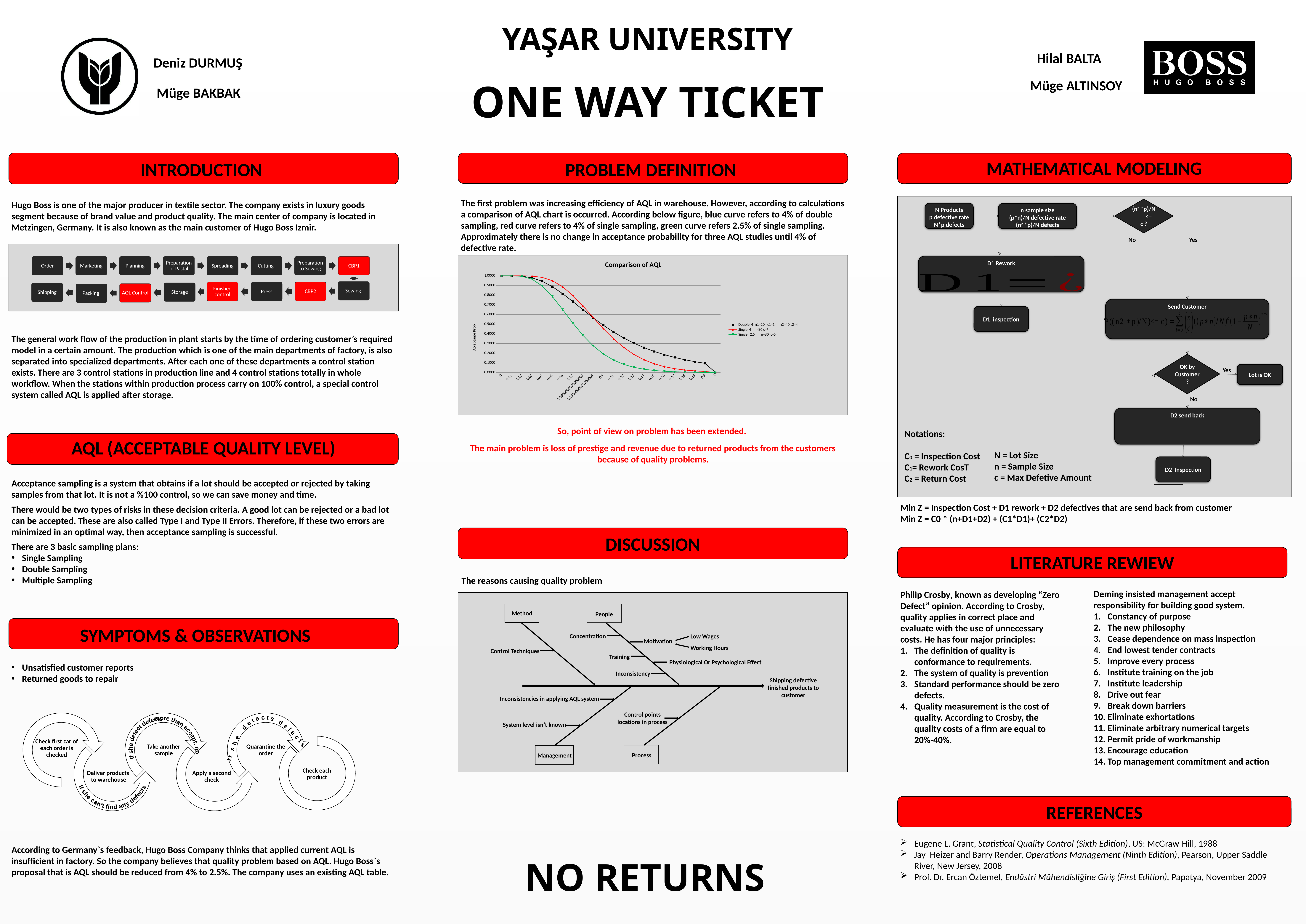
In the "Comparison of AQL" chart, which series has the lowest acceptance probability at a defective rate of 0.1? Single 2.5 In the "Comparison of AQL" chart, is the value of the green "Single 2.5" curve at a defective rate of 0.15 greater or less than 0.1000? less How many series does the legend of the "Comparison of AQL" chart list? 3 What is the highest tick value shown on the vertical axis of the "Comparison of AQL" chart? 1.0000 What is the title of the chart in the Problem Definition section? Comparison of AQL What is the label of the vertical axis in the "Comparison of AQL" chart? Acceptance Prob In the "Comparison of AQL" chart, is the value of the black "Double 4" curve at a defective rate of 0.2 greater or less than 0.2000? less What kind of chart is the "Comparison of AQL" chart? line chart In the "Comparison of AQL" chart, do the acceptance probability values rise or fall as the defective rate increases along the x axis? fall In the "Comparison of AQL" chart, which series has the highest acceptance probability at a defective rate of 0.15? Double 4 In the "Comparison of AQL" chart, at a defective rate of 0.1, which curve has the higher acceptance probability: the black "Double 4" curve or the green "Single 2.5" curve? Double 4 In the "Comparison of AQL" chart, is the value of the red "Single 4" curve at a defective rate of 0.02 greater or less than 0.9000? greater